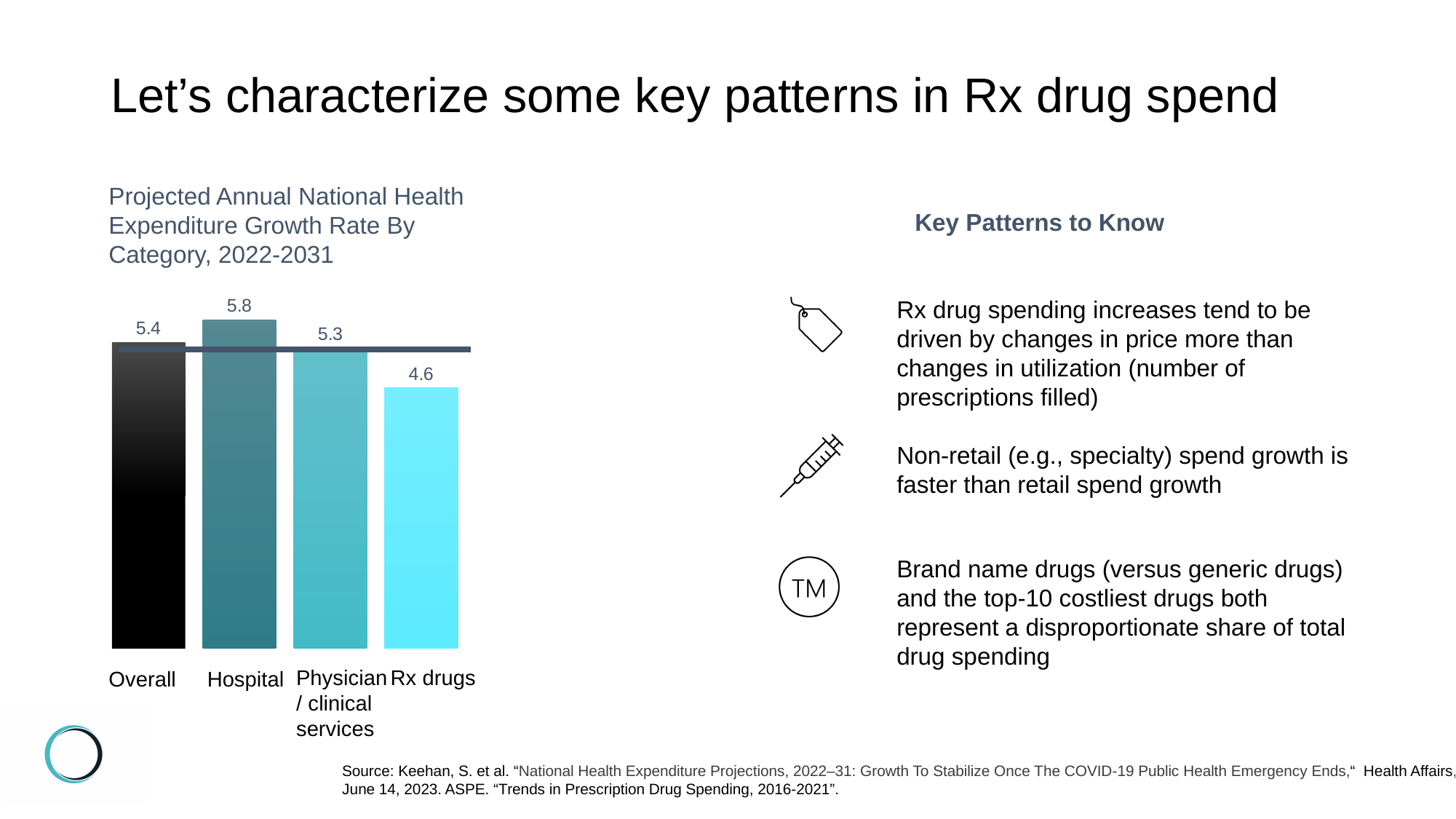
What is the difference between the Hospital and Rx drugs growth rates? 1.2 What is the projected annual growth rate for Hospital? 5.8 Which is larger, the growth rate for Hospital or for Overall? Hospital What is the projected annual growth rate for Rx drugs? 4.6 What is the projected annual growth rate for Overall? 5.4 What is the title of the chart? Projected Annual National Health Expenditure Growth Rate By Category, 2022-2031 How many categories are shown in the chart? 4 Which category has the highest projected growth rate? Hospital What is the difference between the Overall and Rx drugs growth rates? 0.8 What is the projected annual growth rate for Physician / clinical services? 5.3 What kind of chart is shown on the slide? Bar chart Which category has the lowest projected growth rate? Rx drugs